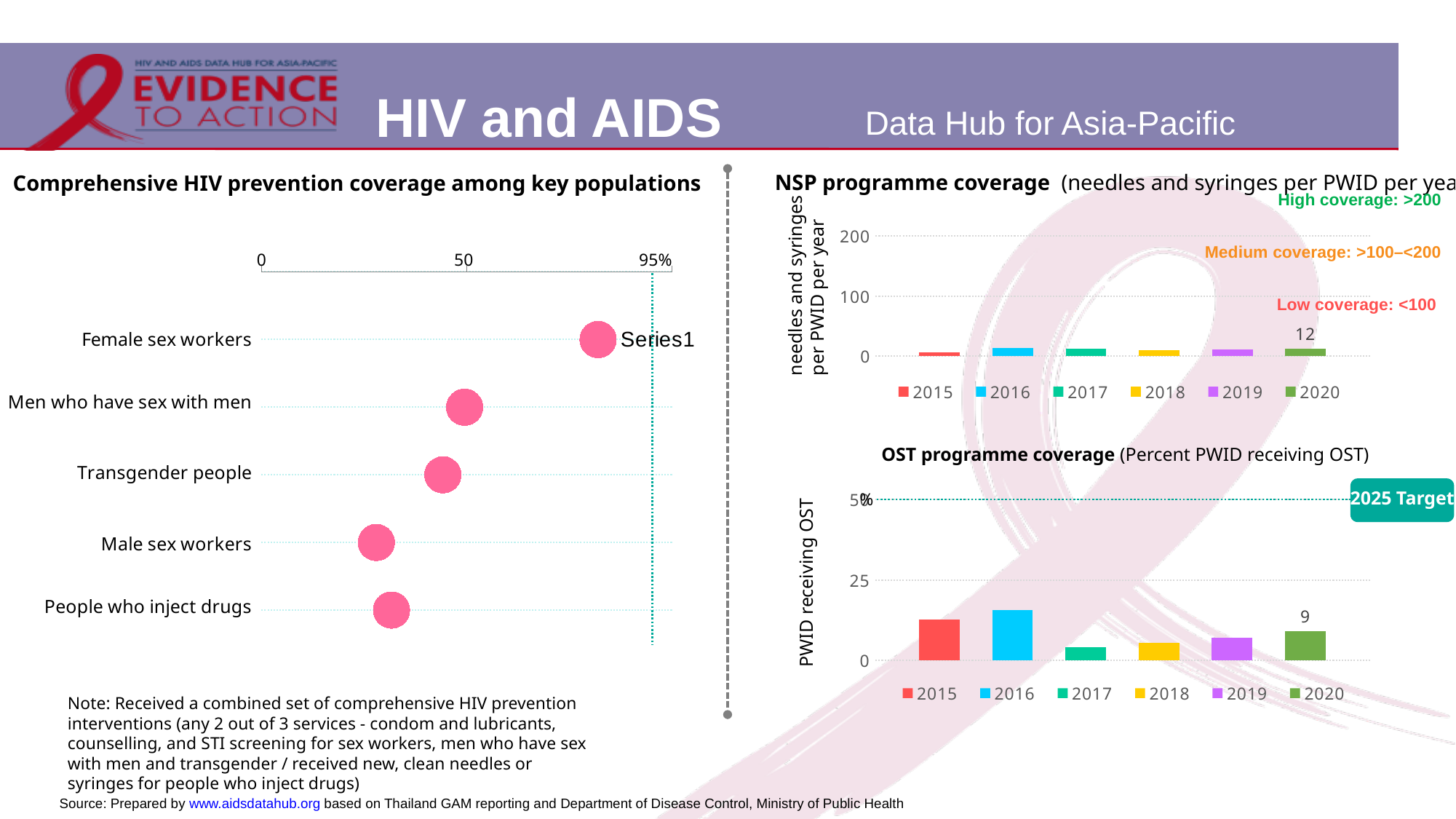
In the 'Comprehensive HIV prevention coverage among key populations' chart, is the value for Male sex workers greater or less than 50? less In the 'NSP programme coverage' chart, what is the value for 2020? 12 In the 'OST programme coverage' chart, which year has the lowest value? 2017 How many key populations are shown in the 'Comprehensive HIV prevention coverage among key populations' chart? 5 How many series does the legend of the 'OST programme coverage' chart list? 6 In the 'NSP programme coverage' chart, is the value for 2016 greater or less than 100? less In the 'Comprehensive HIV prevention coverage among key populations' chart, is the value for Female sex workers greater or less than 50? greater What kind of chart is the 'NSP programme coverage' chart? bar chart In the 'OST programme coverage' chart, what is the value for 2020? 9 In the 'Comprehensive HIV prevention coverage among key populations' chart, which key population has the highest value? Female sex workers In the 'OST programme coverage' chart, which year has the highest value? 2016